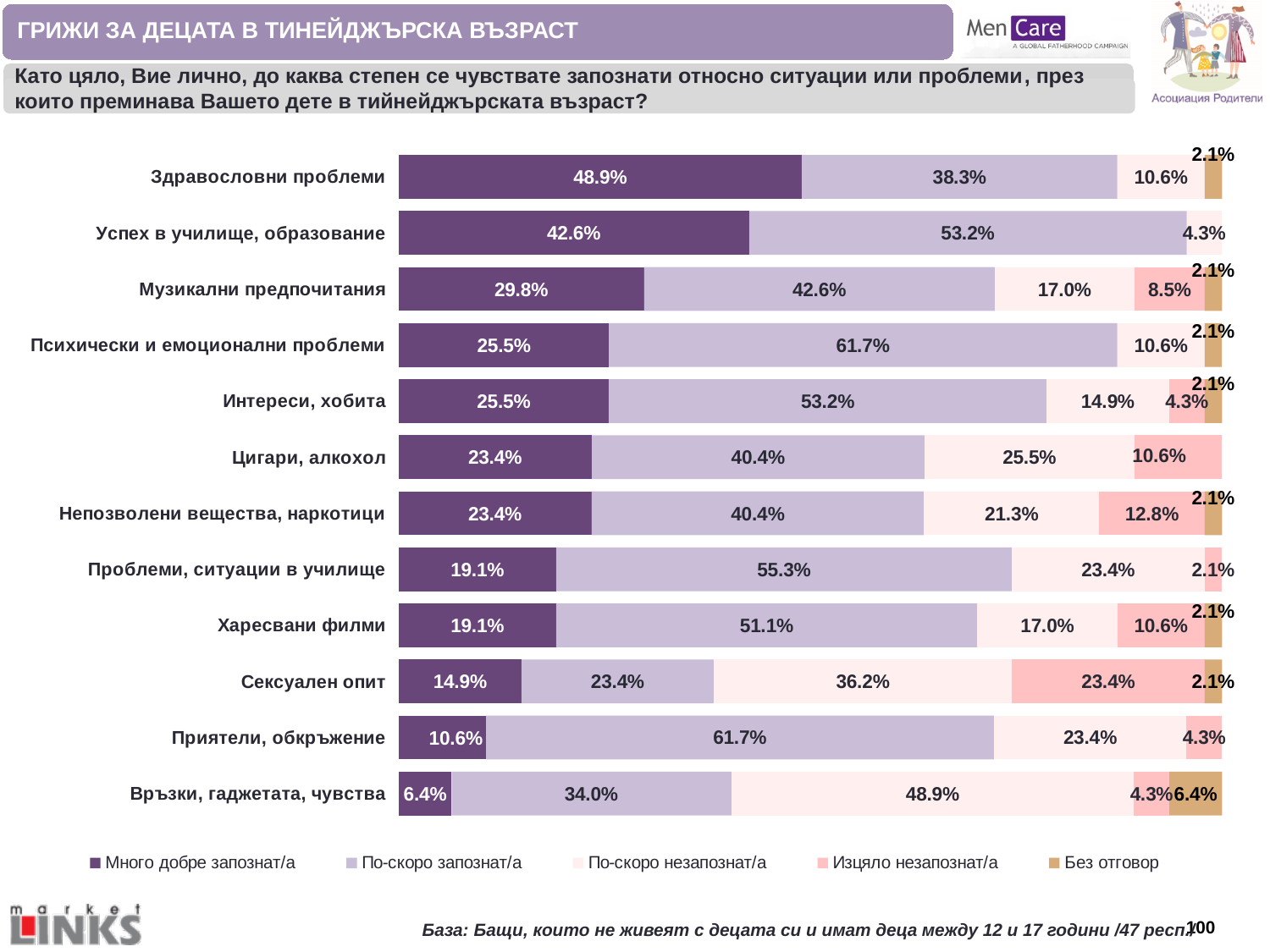
What is the "Изцяло незапознат/а" value for "Сексуален опит"? 23.4% Which category has the highest "Много добре запознат/а" share? Здравословни проблеми What percentage of respondents answered "Много добре запознат/а" for "Здравословни проблеми"? 48.9% What is the "По-скоро незапознат/а" value for "Връзки, гаджетата, чувства"? 48.9% What kind of chart is shown on the slide? Stacked bar chart Which has a larger "По-скоро запознат/а" share: "Приятели, обкръжение" or "Цигари, алкохол"? Приятели, обкръжение Which legend entry is shown in the darkest purple colour? Много добре запознат/а Which category has the lowest "Много добре запознат/а" share? Връзки, гаджетата, чувства How many series does the legend list? 5 How many categories are shown in the chart? 12 What is the "По-скоро запознат/а" value for "Психически и емоционални проблеми"? 61.7% What is the difference in the "Много добре запознат/а" share between "Здравословни проблеми" and "Успех в училище, образование"? 6.3 percentage points